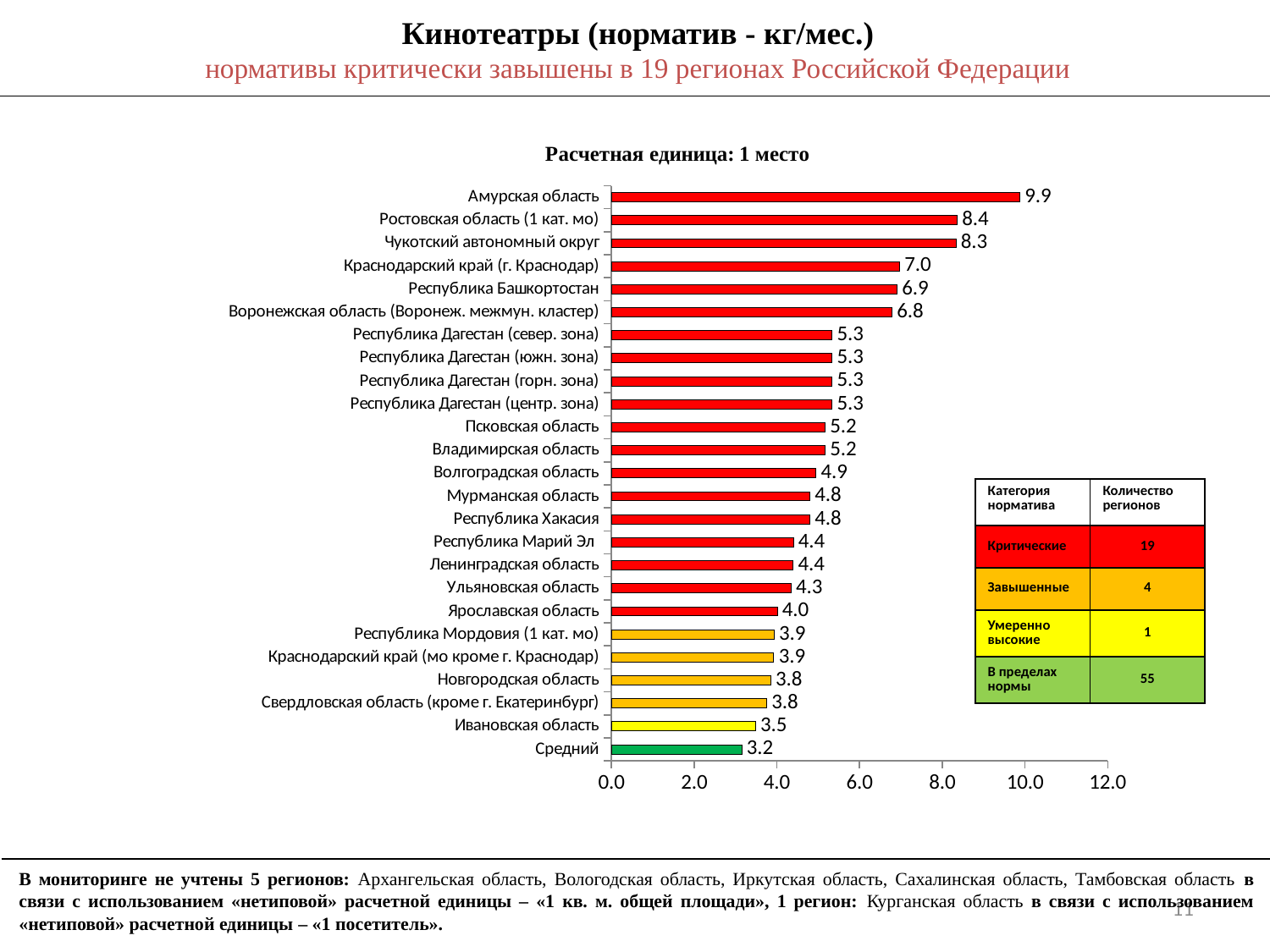
Which is larger, the value for Чукотский автономный округ or the value for Краснодарский край (г. Краснодар)? Чукотский автономный округ What is the value for Ивановская область? 3.5 Which category has the lowest value? Средний Which category has the highest value? Амурская область Is the value for Волгоградская область greater or less than 4.0? greater What is the difference between the values for Амурская область and Ростовская область (1 кат. мо)? 1.5 What is the title of the chart? Расчетная единица: 1 место What kind of chart is shown on the slide? bar chart What is the value for Амурская область? 9.9 How many categories are plotted on the chart? 25 What is the value for Республика Башкортостан? 6.9 What is the value for Средний? 3.2